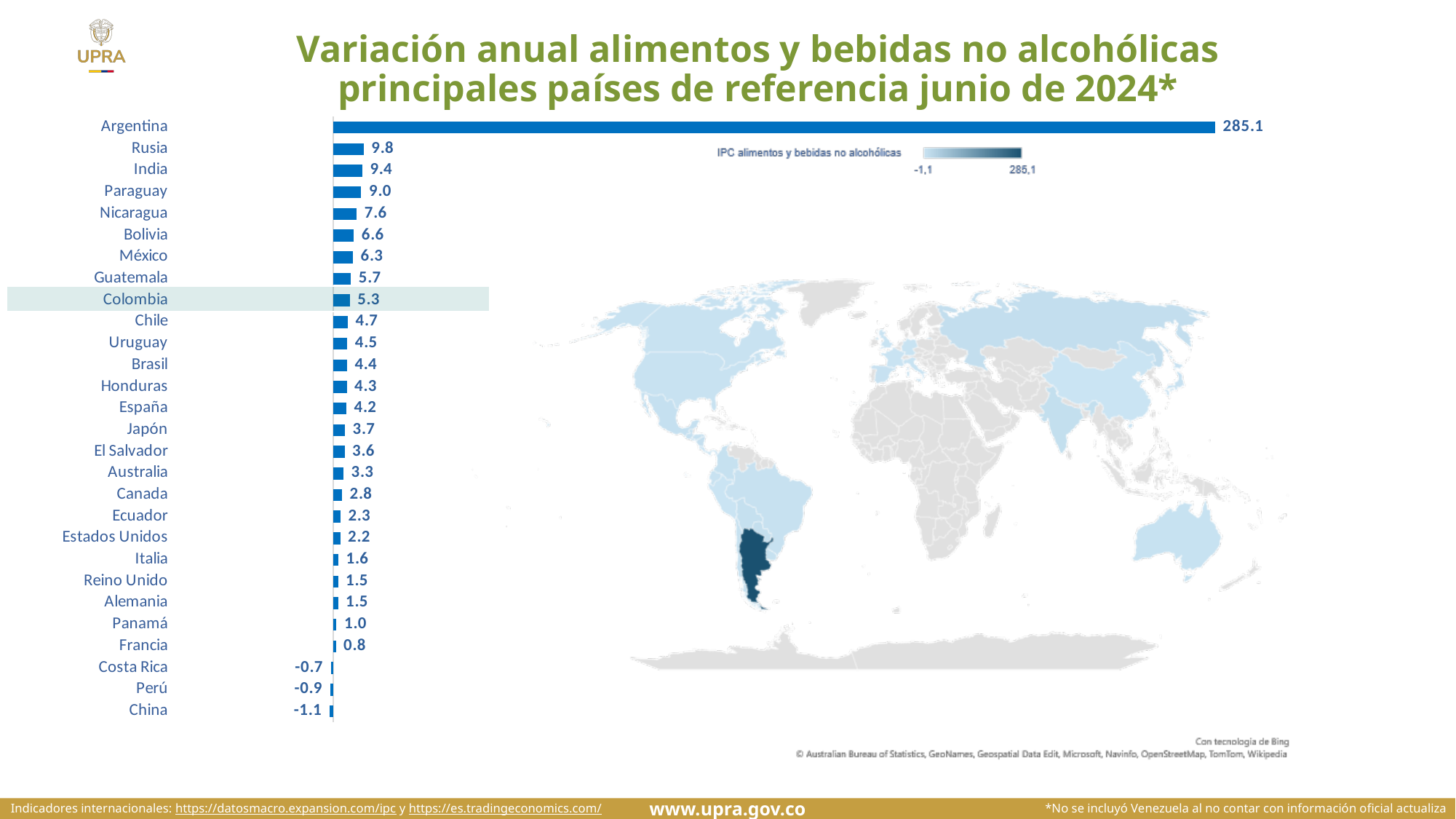
What is the title of the slide's chart? Variación anual alimentos y bebidas no alcohólicas principales países de referencia junio de 2024* In the bar chart, which has a larger value, México or Guatemala? México In the bar chart, what is the value for Estados Unidos? 2.2 In the bar chart, what is the value for China? -1.1 In the bar chart, what is the value for Argentina? 285.1 In the bar chart, what is the value for Colombia? 5.3 How many countries are shown in the bar chart? 28 In the bar chart, how many countries have a negative value? 3 In the bar chart, what is the difference between the values for Rusia and India? 0.4 In the bar chart, which country has the lowest value? China What kind of chart is on the left side of the slide? Bar chart In the bar chart, which country has the highest value? Argentina